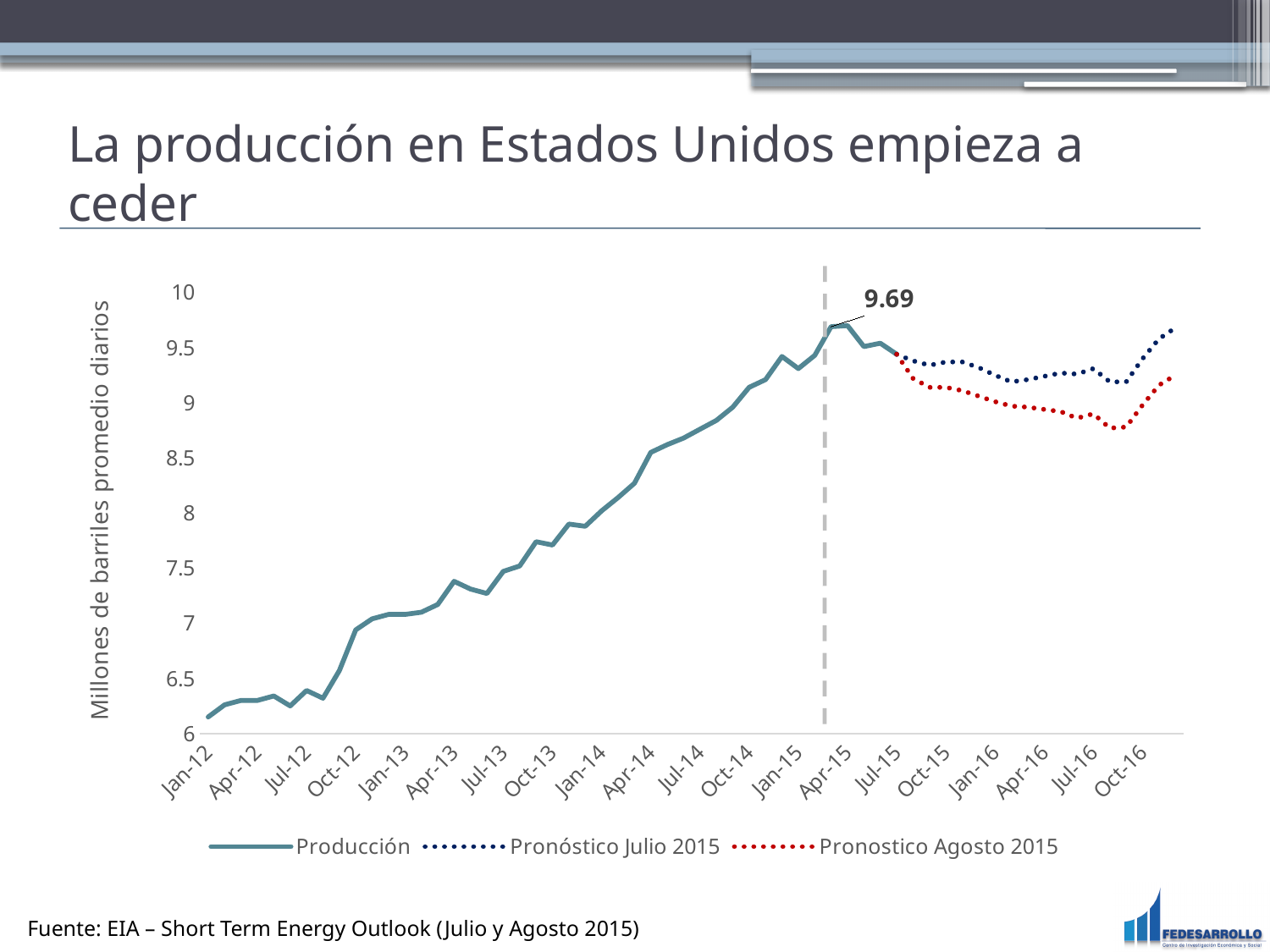
Which of the two forecast series is lower over the forecast period? Pronostico Agosto 2015 What is the title of the vertical axis? Millones de barriles promedio diarios Is the value of Producción at Jan-14 greater or less than 7.5? greater What kind of chart is shown on the slide? line chart At Oct-16, which series is higher: Pronóstico Julio 2015 or Pronostico Agosto 2015? Pronóstico Julio 2015 How many series does the legend list? 3 Is the value of Pronóstico Julio 2015 at Jan-16 greater or less than 9? greater Does Producción rise or fall from Jan-12 to Apr-15? rise Is the value of Producción at Jan-12 greater or less than 6.5? less Which series is drawn as a solid line? Producción What is the peak value of Producción labelled on the chart? 9.69